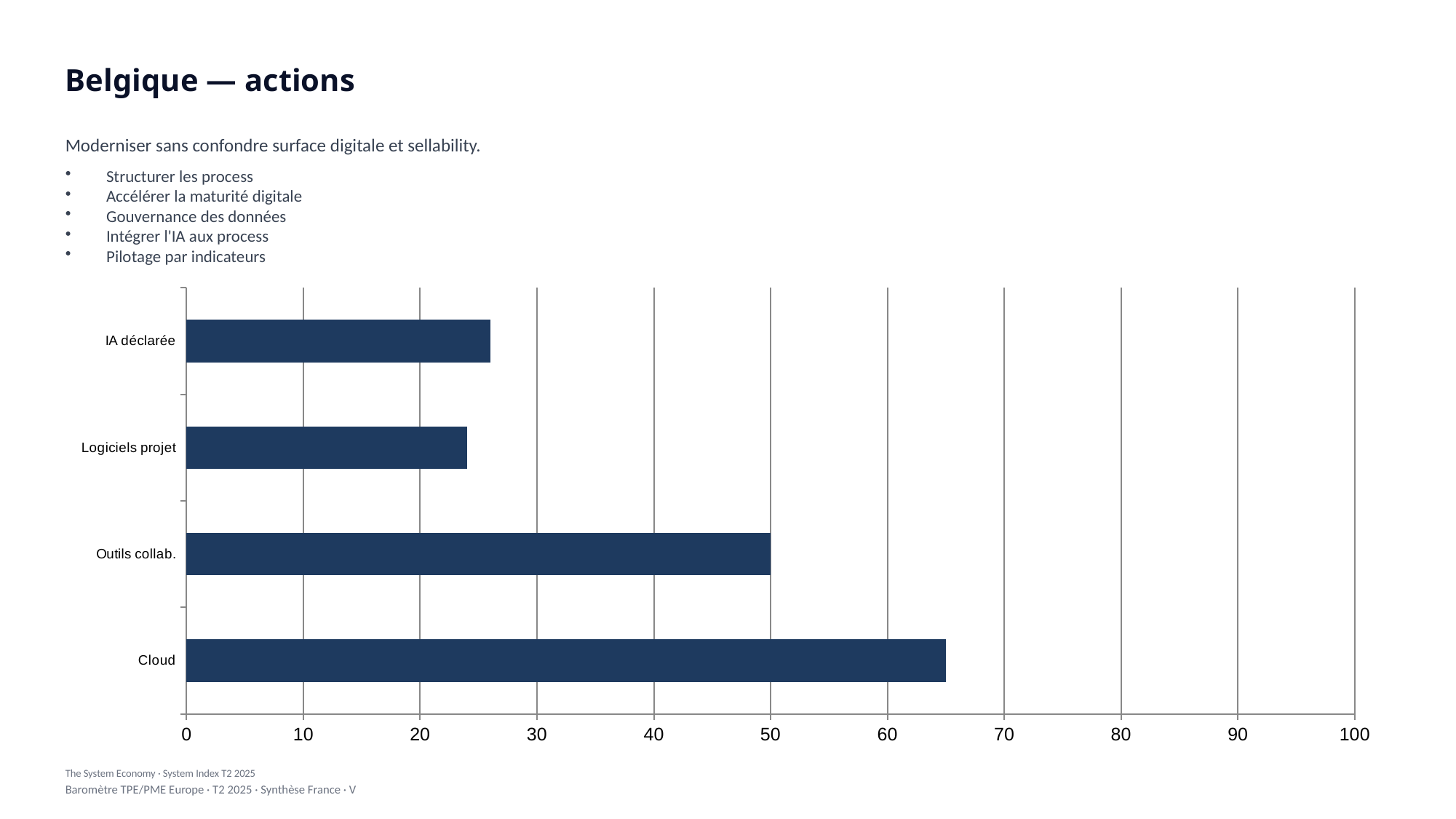
How many categories are plotted in the chart? 4 Is the value for Cloud greater or less than 60? greater Is the value for Cloud greater or less than 70? less What is the value for Outils collab.? 50 Which category has the highest value in the chart? Cloud Which is larger, the value for Cloud or the value for Outils collab.? Cloud What is the maximum value shown on the horizontal axis of the chart? 100 What kind of chart is shown on the slide? bar chart What is the title of the slide containing the chart? Belgique — actions Is the value for Logiciels projet greater or less than 20? greater Which is larger, the value for Outils collab. or the value for IA déclarée? Outils collab.